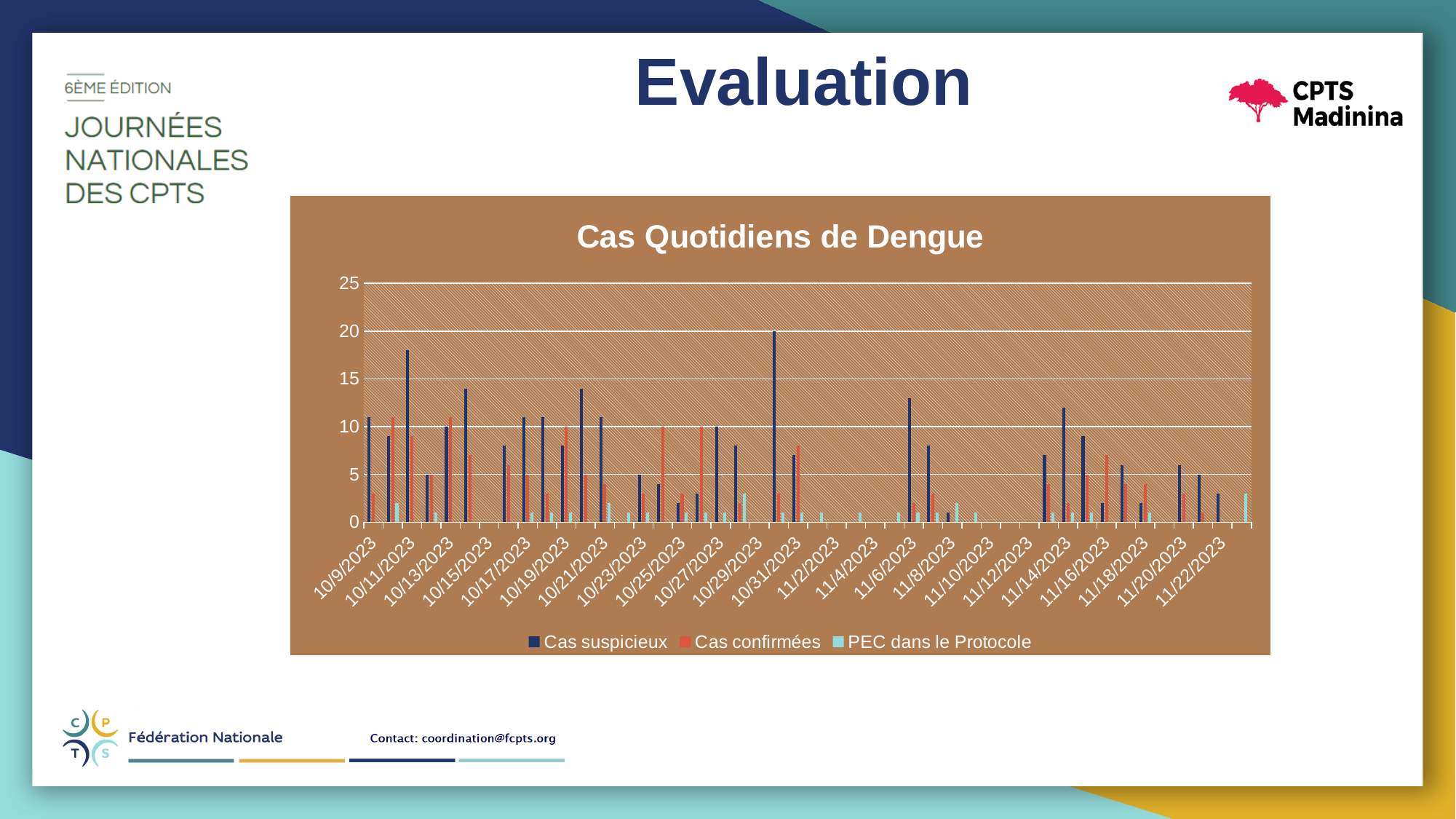
Is the Cas confirmées value on 11/18/2023 greater or less than 5? less Is the Cas suspicieux value on 11/6/2023 greater or less than 10? greater How many series does the legend of the chart list? 3 What is the title of the chart? Cas Quotidiens de Dengue What is the highest value shown on the vertical axis of the chart? 25 On which date does the Cas suspicieux series reach its highest value? 10/30/2023 Which series is shown in dark blue in the chart? Cas suspicieux Is the Cas suspicieux value on 10/11/2023 greater or less than 15? greater What kind of chart is shown on the slide? bar chart